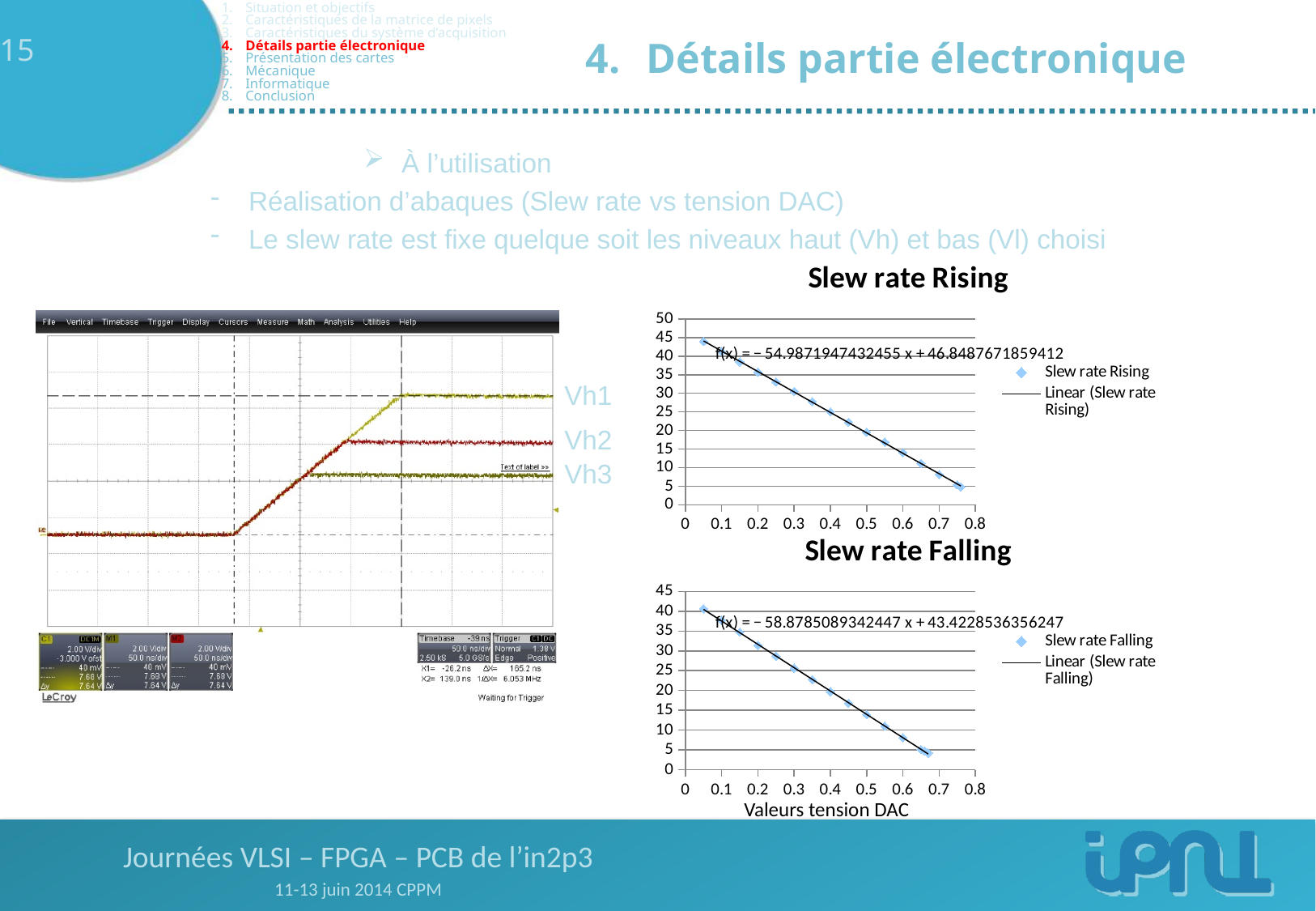
In the 'Slew rate Rising' chart, do the values rise or fall as the DAC voltage increases along the x axis? fall In the 'Slew rate Falling' chart, is the value at x = 0.3 greater or less than 20? greater What trendline equation is printed on the 'Slew rate Falling' chart? f(x) = − 58.8785089342447 x + 43.4228536356247 How many entries does the legend of the 'Slew rate Falling' chart list? 2 What kind of chart is the 'Slew rate Rising' chart? scatter chart In the 'Slew rate Falling' chart, do the values rise or fall as the DAC voltage increases along the x axis? fall In the 'Slew rate Rising' chart, is the value at x = 0.2 greater or less than 30? greater How many entries does the legend of the 'Slew rate Rising' chart list? 2 What is the x-axis label shown under the 'Slew rate Falling' chart? Valeurs tension DAC In the 'Slew rate Rising' chart, is the value at x = 0.6 greater or less than 20? less